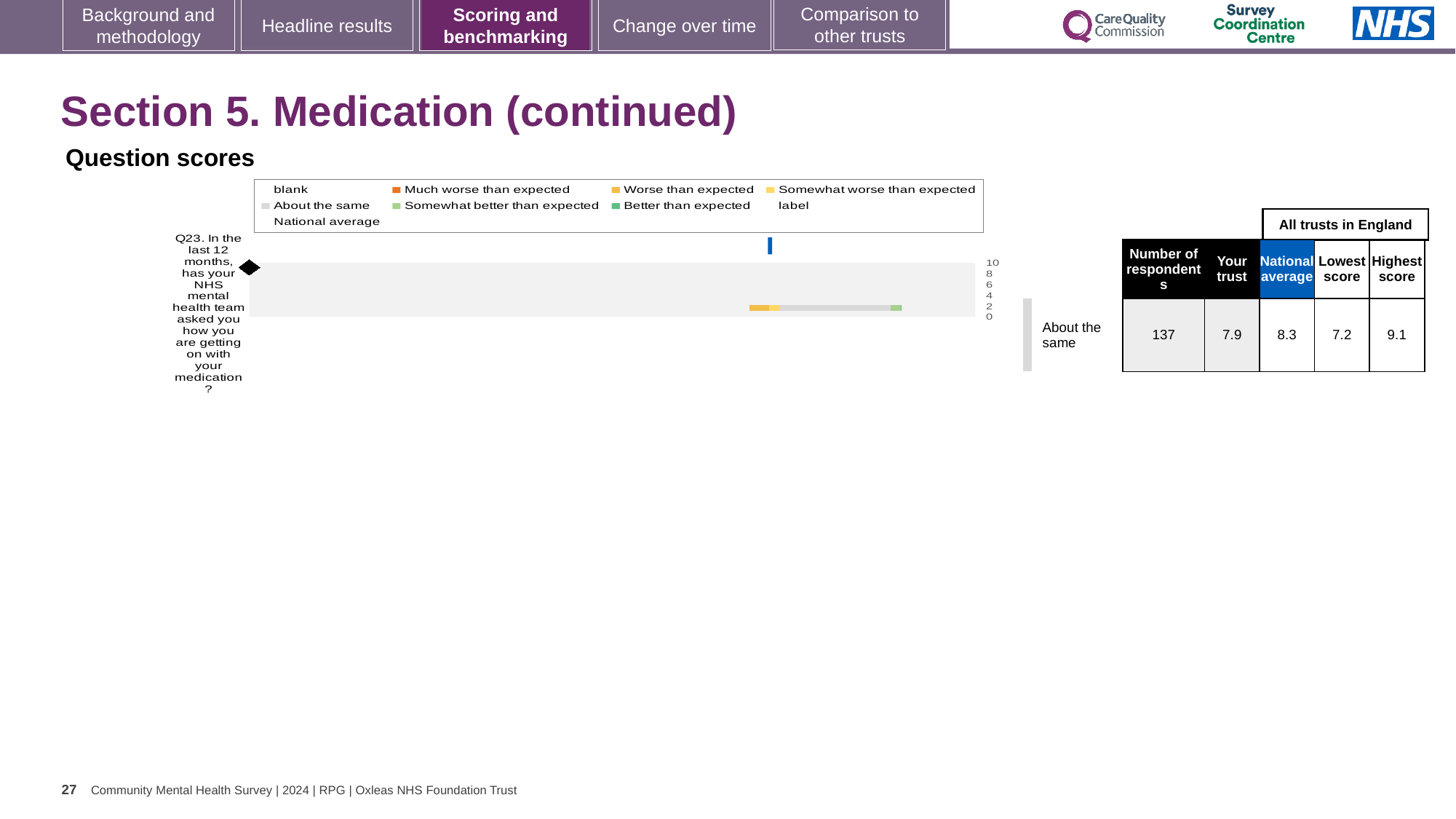
What does the blue marker on the chart represent, according to the legend? National average What is the highest score among all trusts in England for Q23? 9.1 How many survey questions are plotted on the chart? 1 By how much does the national average exceed the trust's score for Q23? 0.4 What is the 'Your trust' score for Q23? 7.9 What is the lowest score among all trusts in England for Q23? 7.2 What is the difference between the highest and lowest scores for Q23 across all trusts in England? 1.9 What kind of chart is used to show the Q23 question score? bar chart What is the national average score for Q23? 8.3 For Q23, which is larger: the trust's score or the national average? National average How many respondents answered Q23 according to the table next to the chart? 137 What is the benchmark category shown for Q23 (how the trust compares with what is expected)? About the same